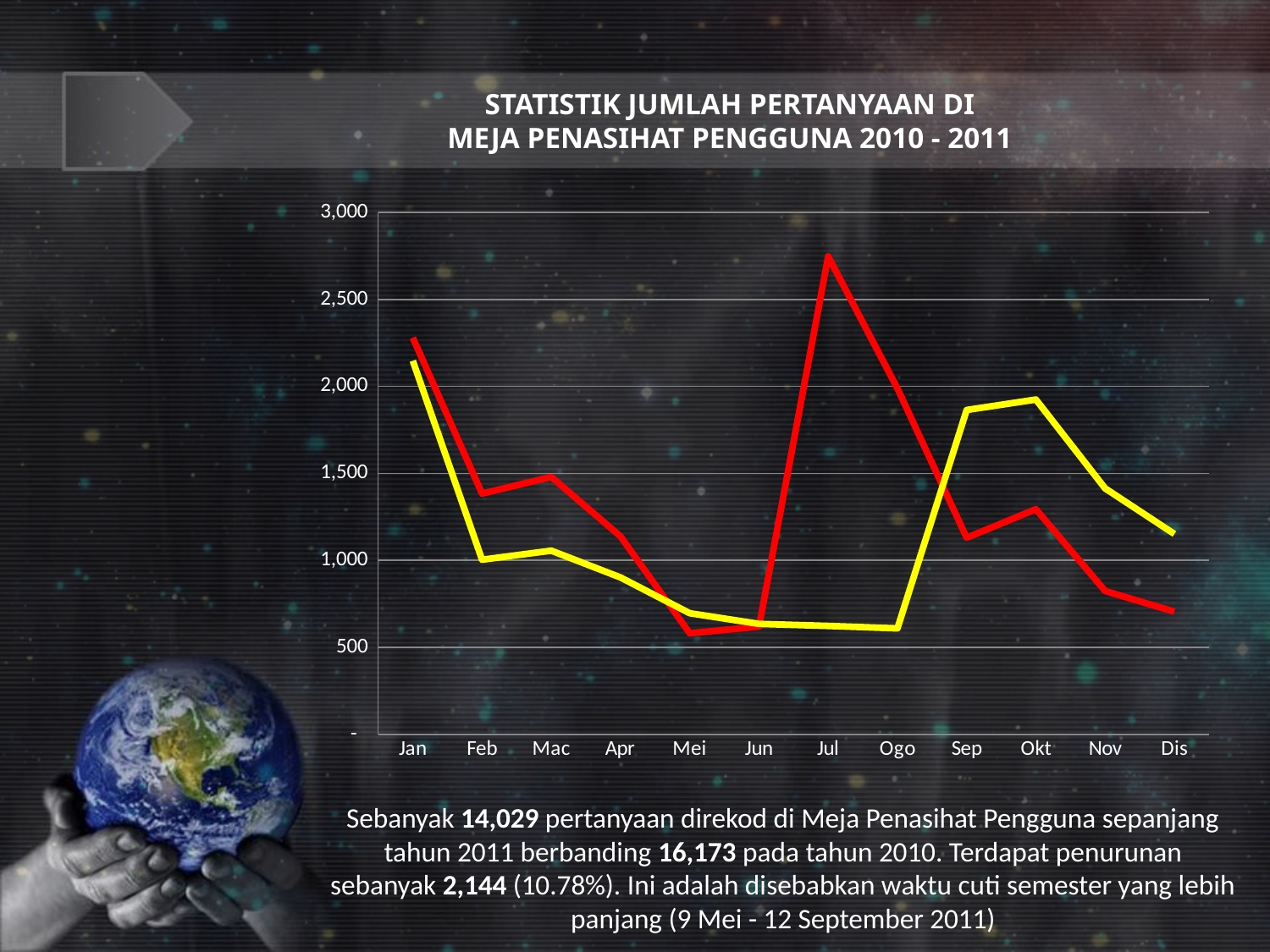
What is the title of the chart? STATISTIK JUMLAH PERTANYAAN DI MEJA PENASIHAT PENGGUNA 2010 - 2011 Is the value of the red line in Dis greater or less than 1,000? less Which line has the higher value in Sep, the red line or the yellow line? yellow line How many lines are plotted on the chart? 2 Is the value of the red line in Jul greater or less than 2,500? greater What kind of chart is shown on the slide? line chart In which month does the yellow line reach its highest value? Jan How many months are shown along the x axis of the chart? 12 Is the value of the yellow line in Sep greater or less than 1,500? greater Does the yellow line rise or fall from Jan to Mei? fall Which line has the higher value in Feb, the red line or the yellow line? red line In which month does the red line reach its highest value? Jul